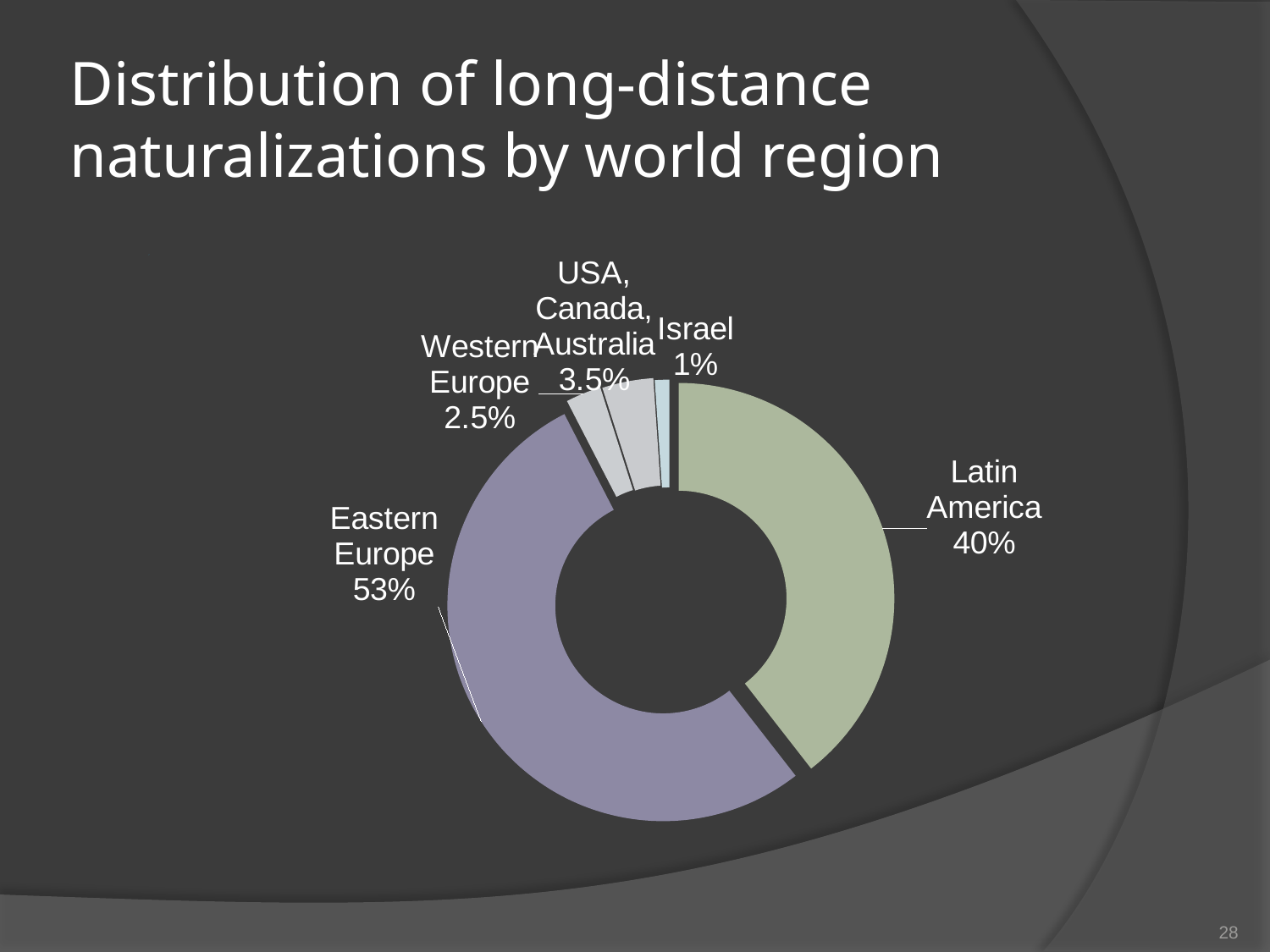
What kind of chart is shown on the slide? Doughnut (pie) chart How many world regions are shown in the chart? 5 What share of long-distance naturalizations is from USA, Canada, Australia? 3.5% Which world region has the largest share of long-distance naturalizations? Eastern Europe What is the difference in percentage points between the Eastern Europe and Latin America shares? 13 percentage points What is the title of the chart on the slide? Distribution of long-distance naturalizations by world region Which world region has the smallest share of long-distance naturalizations? Israel What share of long-distance naturalizations is from Western Europe? 2.5% Which has a larger share: Western Europe or USA, Canada, Australia? USA, Canada, Australia What share of long-distance naturalizations is from Eastern Europe? 53% What share of long-distance naturalizations is from Israel? 1% What share of long-distance naturalizations is from Latin America? 40%